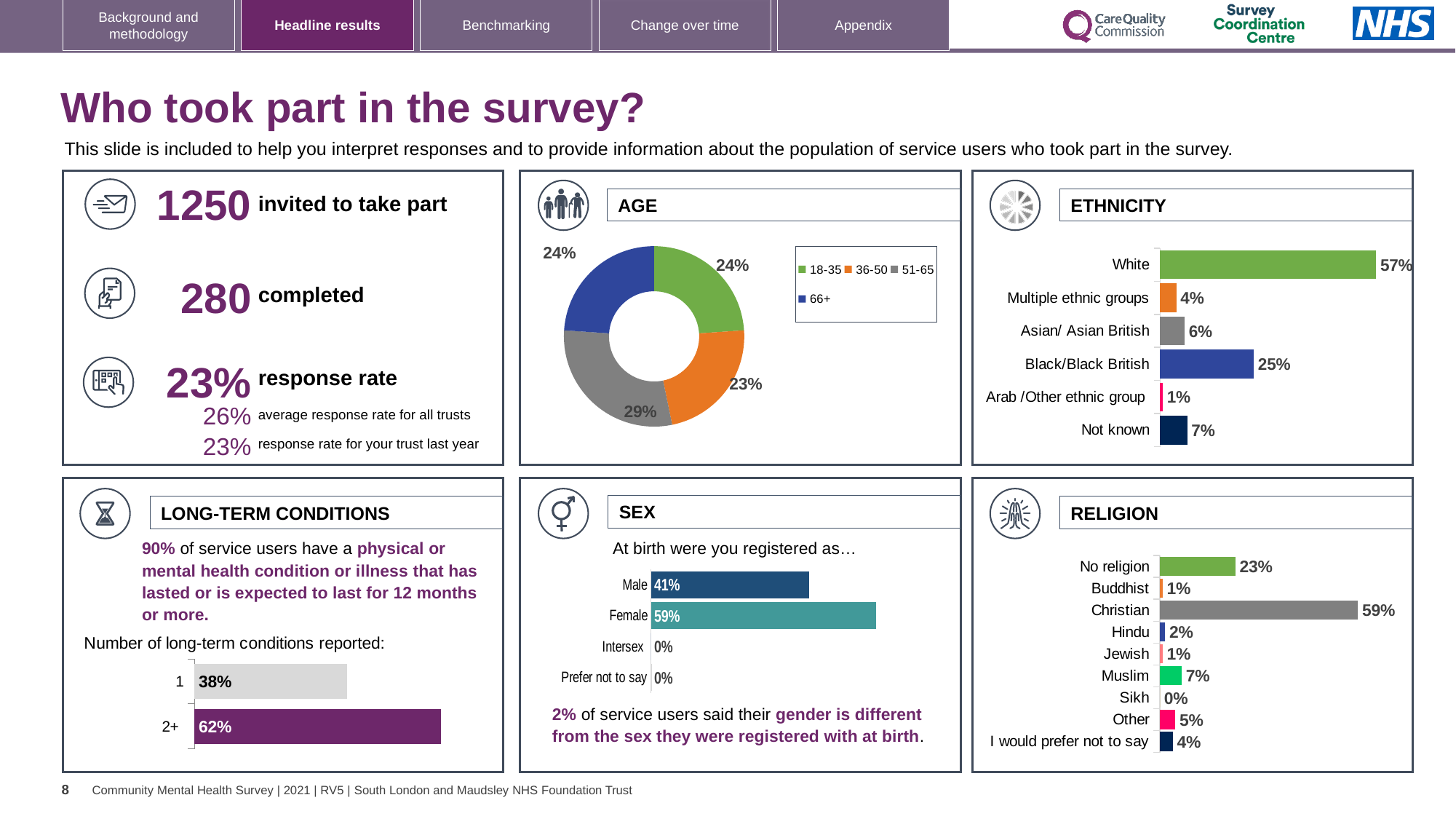
In the ETHNICITY chart, which category has the lowest value? Arab /Other ethnic group What kind of chart is the AGE chart? Doughnut chart In the ETHNICITY chart, what is the difference between White and Black/Black British? 32% In the AGE chart, which age group has the largest share? 51-65 In the ETHNICITY chart, what is the value for Black/Black British? 25% In the RELIGION chart, what is the value for Muslim? 7% In the SEX chart, which is larger, Male or Female? Female In the AGE chart, what percentage of respondents were aged 51-65? 29% How many categories are shown in the ETHNICITY chart? 6 In the LONG-TERM CONDITIONS chart, what percentage reported 2+ conditions? 62% How many categories are shown in the RELIGION chart? 9 How many entries does the legend of the AGE chart list? 4